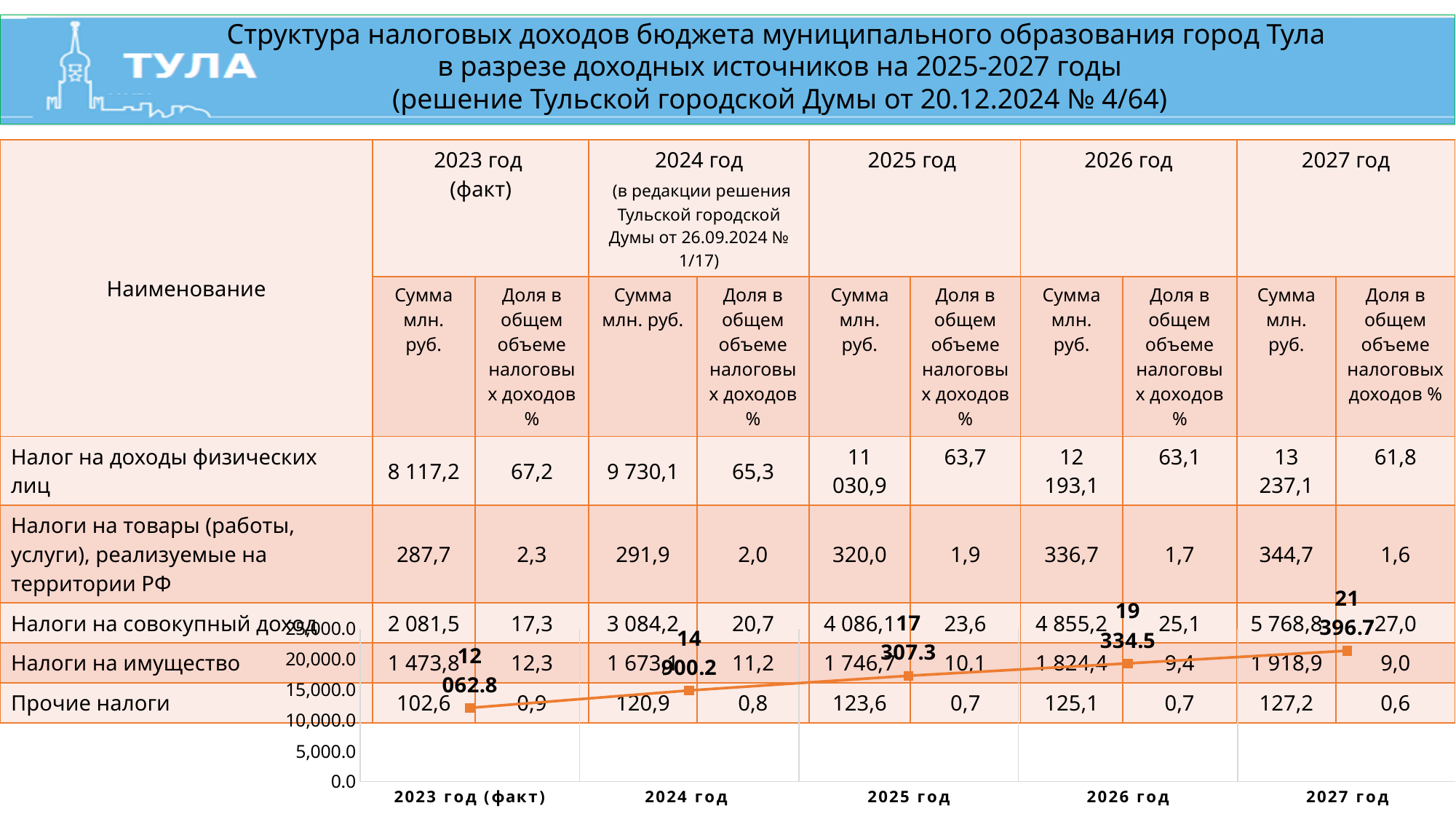
On the line chart, is the value for 2023 год (факт) greater or less than 15,000.0? less What is the value plotted for 2025 год on the line chart? 17 307.3 What kind of chart is shown at the bottom of the slide? line chart On the line chart, what is the difference between the 2027 год value and the 2023 год (факт) value? 9 333.9 How many data points are plotted on the line chart? 5 Which year has the highest value on the line chart? 2027 год On the line chart, which is larger: the value for 2026 год or the value for 2025 год? 2026 год Which year has the lowest value on the line chart? 2023 год (факт) What is the value plotted for 2024 год on the line chart? 14 900.2 Do the values on the line chart rise or fall from 2023 to 2027? rise What is the value plotted for 2023 год (факт) on the line chart? 12 062.8 What is the value plotted for 2027 год on the line chart? 21 396.7